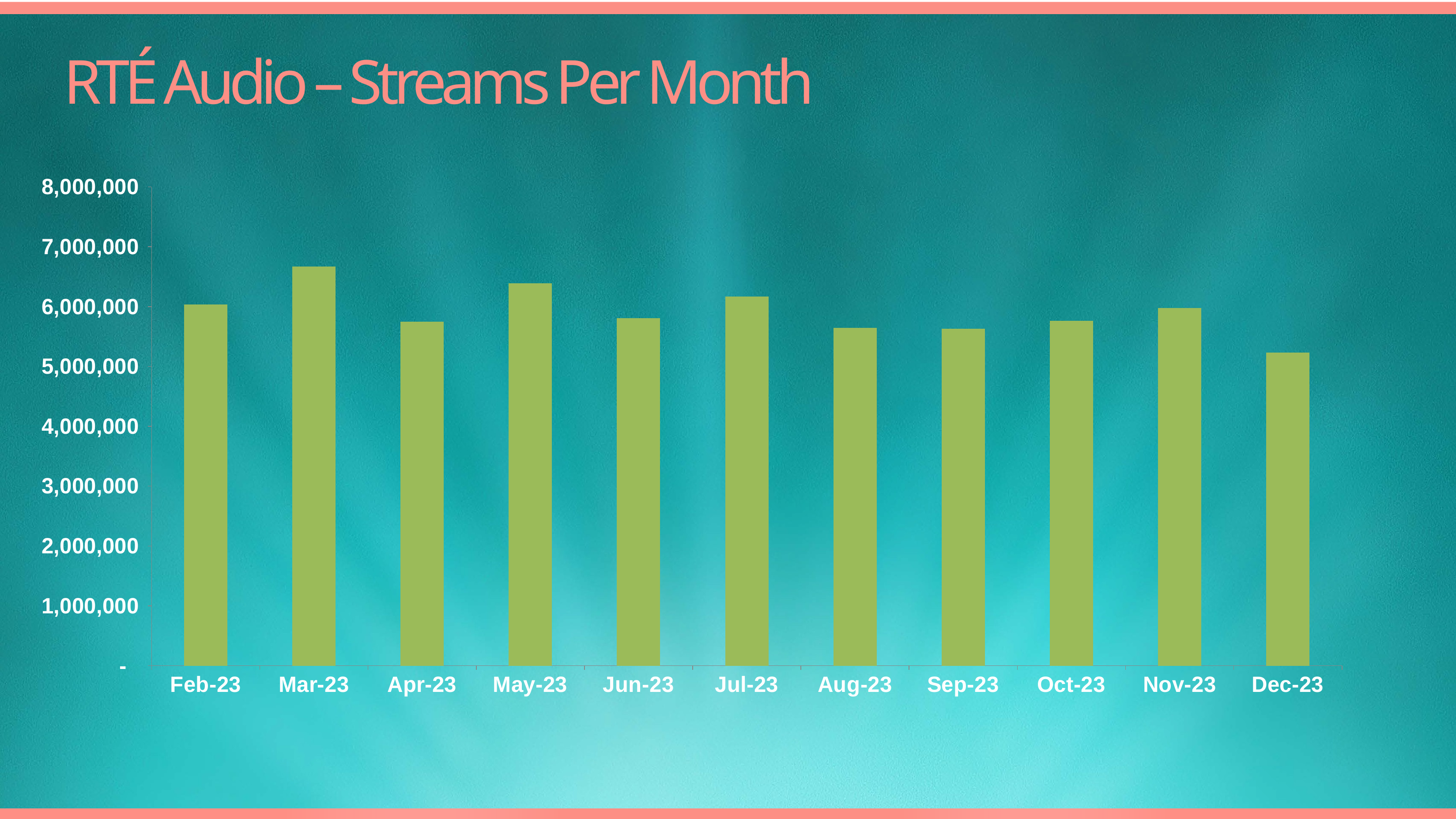
How many months are shown on the x axis of the chart? 11 Which month has the highest number of streams? Mar-23 Is the value for Apr-23 greater or less than 6,000,000? less Which is larger, the value for Jul-23 or the value for Aug-23? Jul-23 Is the value for Mar-23 greater or less than 6,000,000? greater What is the title of the chart? RTÉ Audio – Streams Per Month Which is larger, the value for Mar-23 or the value for Dec-23? Mar-23 Is the value for Dec-23 greater or less than 6,000,000? less Which month has the lowest number of streams? Dec-23 From Sep-23 to Nov-23, do the values rise or fall? rise What kind of chart is shown on the slide? Bar chart